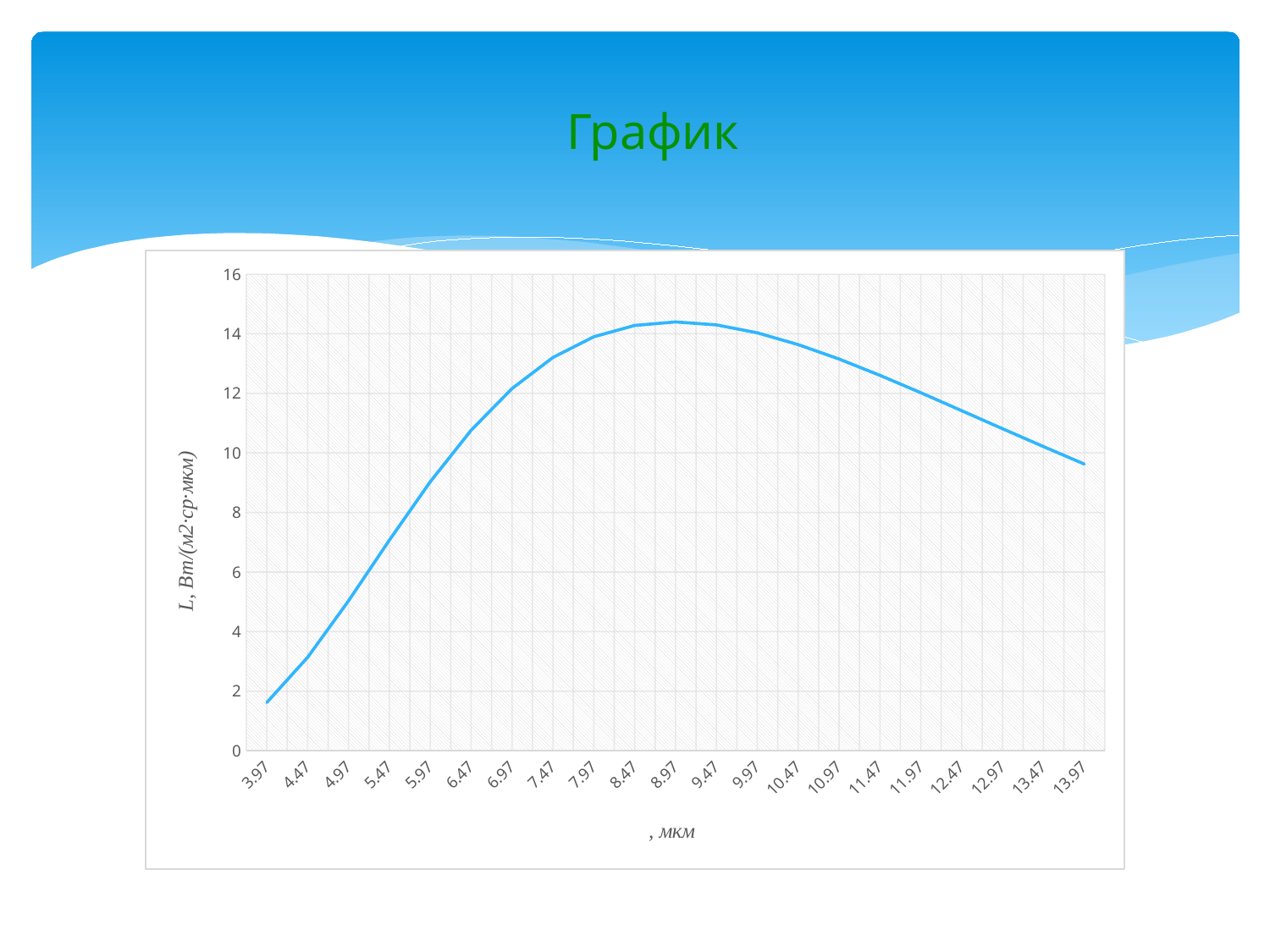
What kind of chart is shown on the slide? line chart At which x-axis value does the line reach its highest point? 8.97 Does the line rise or fall between 9.47 and 13.97? fall Which has the larger value, 4.47 or 13.47? 13.47 Is the value at 3.97 greater or less than 2? less How many x-axis tick labels are shown on the chart? 21 At which x-axis value does the line have its lowest point? 3.97 What is the label on the vertical axis of the chart? L, Вт/(м2·ср·мкм) Is the value at 8.97 greater or less than 14? greater Is the value at 7.97 greater or less than 12? greater Does the line rise or fall between 3.97 and 8.97? rise